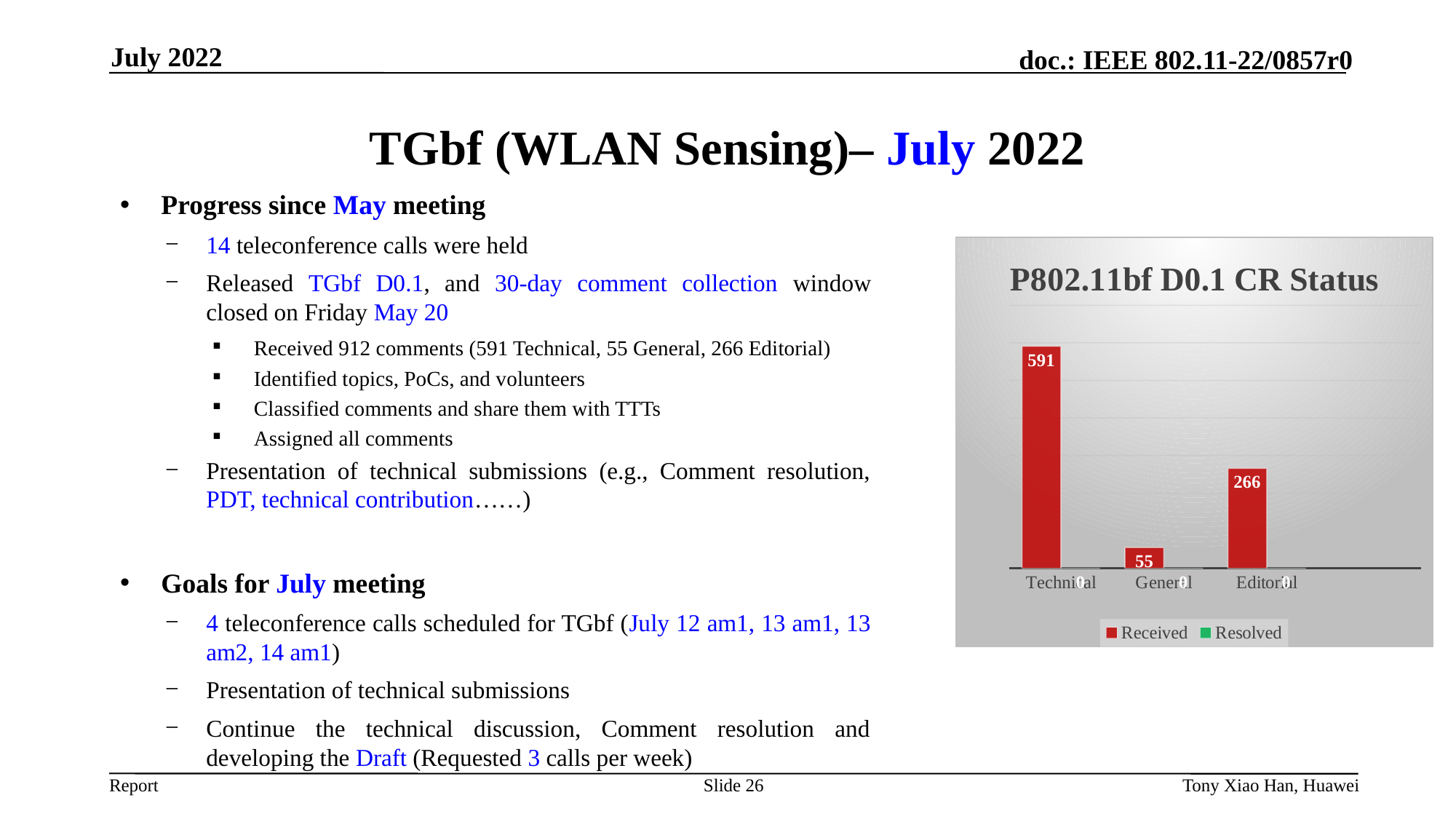
Which has a larger Received value, General or Editorial? Editorial What type of chart is shown on the slide? bar chart What is the title of the chart? P802.11bf D0.1 CR Status What is the difference between the Received values for Technical and Editorial? 325 Which category has the lowest Received value? General How many categories are shown on the x axis of the chart? 3 What colour are the Received bars in the chart? red What is the Received value for Technical? 591 Which category has the highest Received value? Technical What is the Received value for Editorial? 266 How many series does the chart legend list? 2 What is the Received value for General? 55